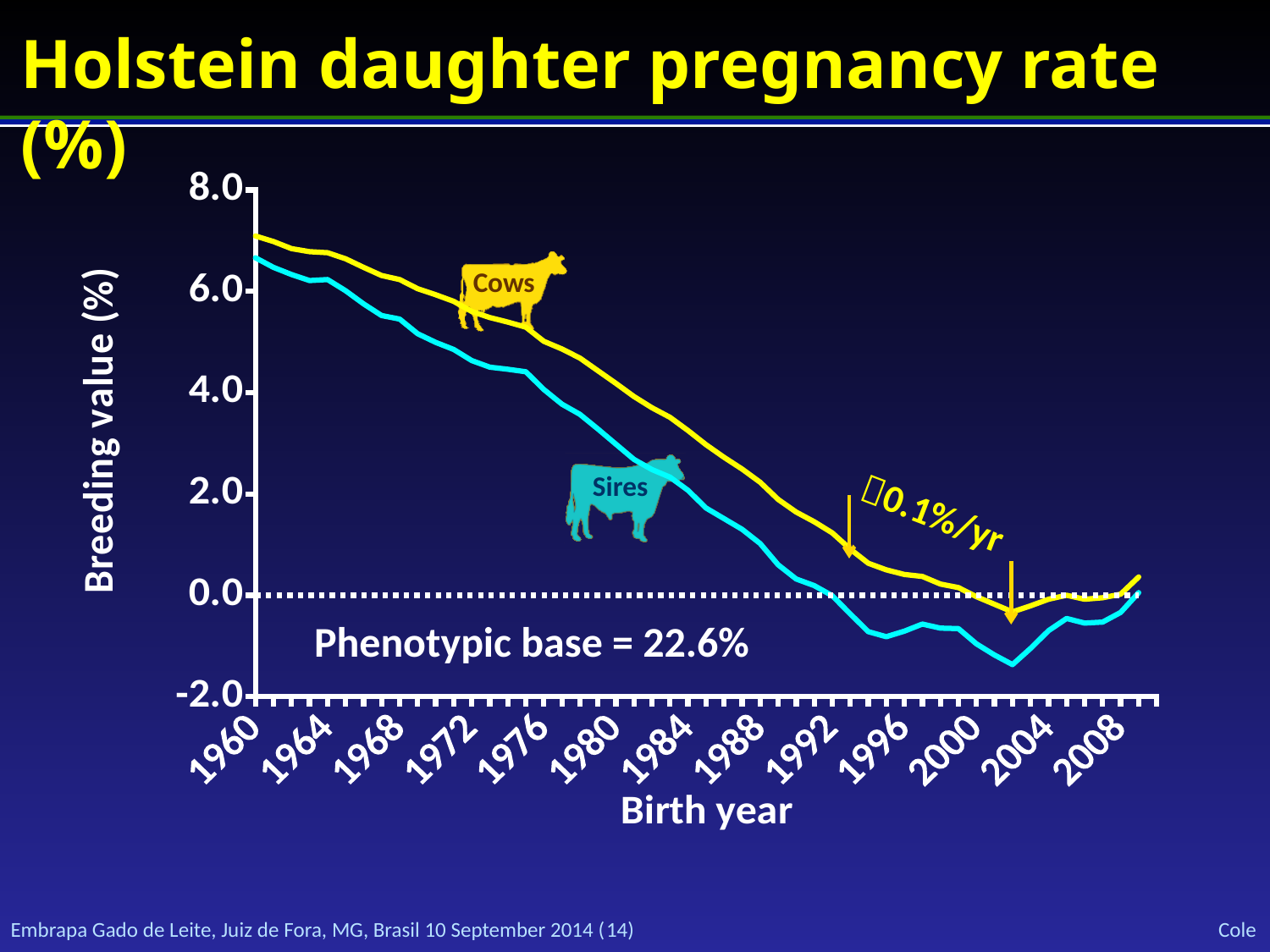
Is the breeding value for Cows in 1996 greater or less than 2.0? less Which series has the higher breeding value in 1980, Cows or Sires? Cows What are the names of the two series plotted on the chart? Cows and Sires Which series is lower across the whole chart, Cows or Sires? Sires How many series are plotted on the chart? 2 Is the breeding value for Cows in 1960 greater or less than 6.0? greater What phenotypic base is stated on the chart? 22.6% Is the breeding value for Sires in 2004 greater or less than 0.0? less What kind of chart is shown on the slide? line chart How many birth-year labels are shown on the x axis? 13 Overall, do the breeding values rise or fall from 1960 to 2004? fall